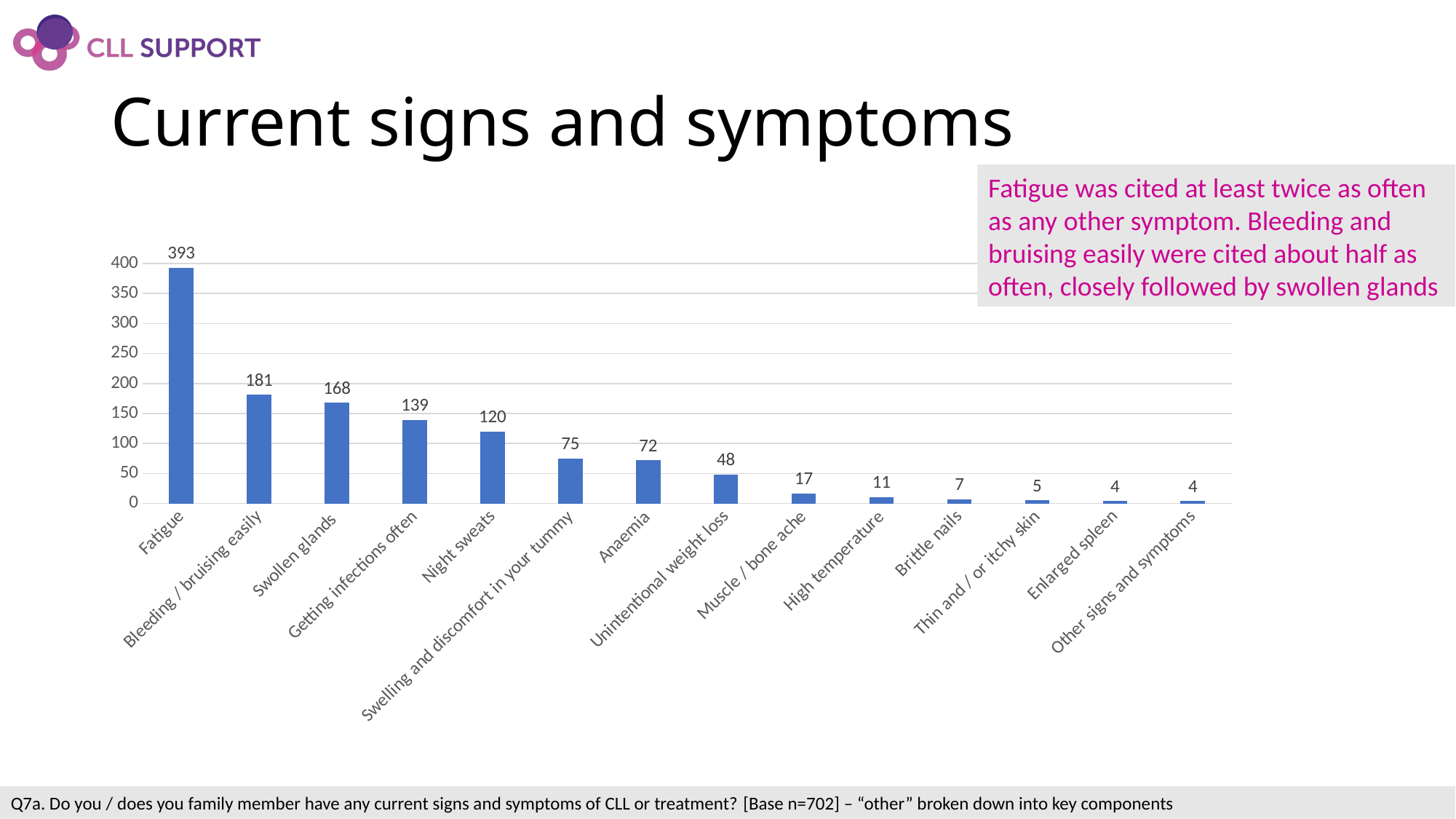
Which category has the highest value? Fatigue What is the value for Fatigue? 393 What is the difference between the values for Getting infections often and Night sweats? 19 What is the difference between the values for Fatigue and Bleeding / bruising easily? 212 Which is larger, the value for Swelling and discomfort in your tummy or the value for Anaemia? Swelling and discomfort in your tummy What is the value for Unintentional weight loss? 48 Is the value for Getting infections often greater or less than 100? greater Do the values rise or fall from left to right along the x axis? Fall What kind of chart is shown on the slide? Bar chart How many categories are shown on the x axis? 14 What is the value for Night sweats? 120 What is the value for Swollen glands? 168